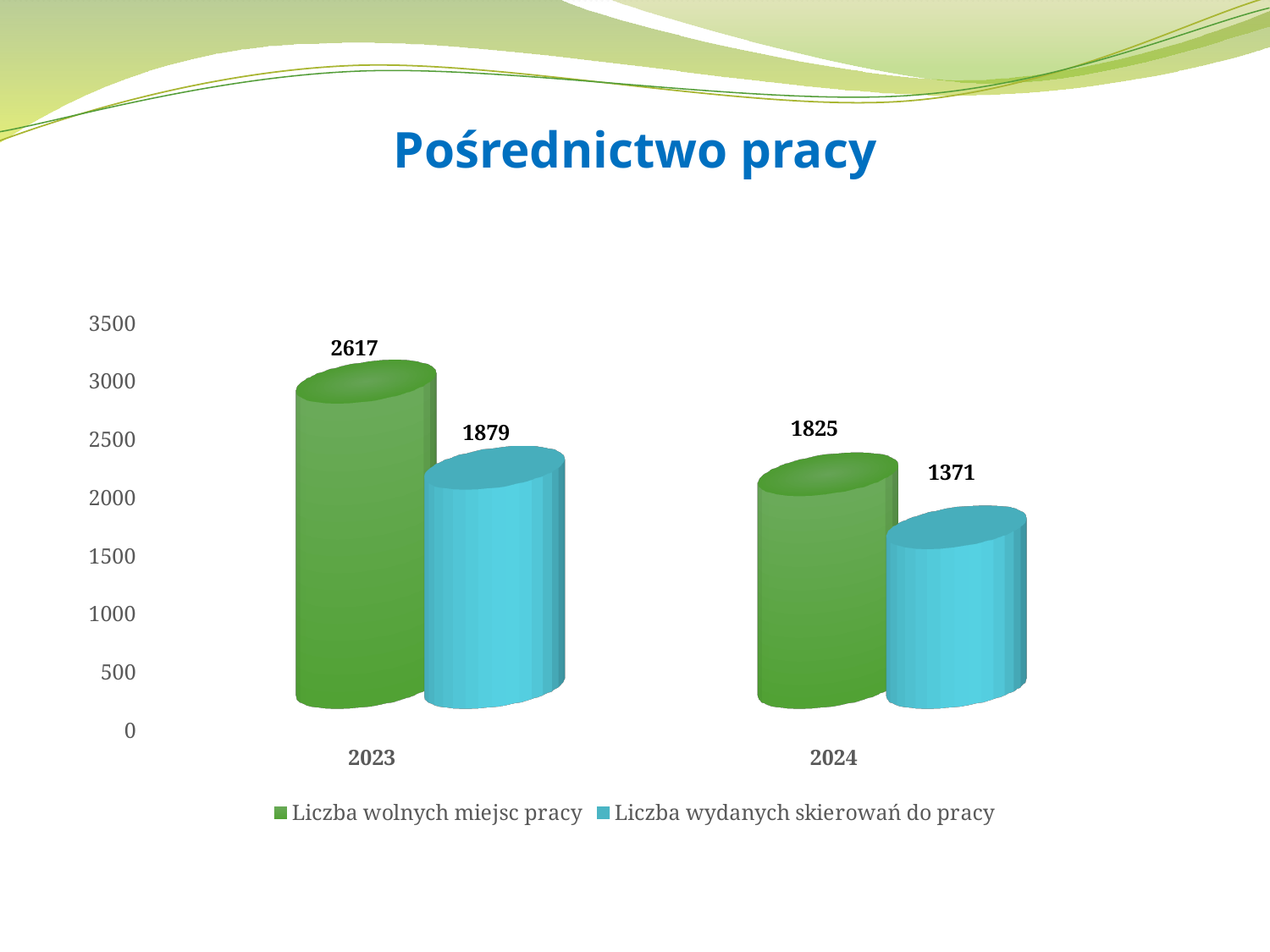
How many series does the legend list? 2 What is the difference between 'Liczba wolnych miejsc pracy' and 'Liczba wydanych skierowań do pracy' in 2023? 738 What is the value of 'Liczba wydanych skierowań do pracy' for 2024? 1371 Which year has the highest value for 'Liczba wolnych miejsc pracy'? 2023 What is the value of 'Liczba wydanych skierowań do pracy' for 2023? 1879 Which is larger: 'Liczba wydanych skierowań do pracy' in 2023 or 'Liczba wolnych miejsc pracy' in 2024? Liczba wydanych skierowań do pracy in 2023 Which year has the lowest value for 'Liczba wydanych skierowań do pracy'? 2024 What kind of chart is shown on the slide? Bar chart What is the value of 'Liczba wolnych miejsc pracy' for 2024? 1825 By how much did 'Liczba wolnych miejsc pracy' decrease from 2023 to 2024? 792 What is the value of 'Liczba wolnych miejsc pracy' for 2023? 2617 How many years are shown on the x axis? 2